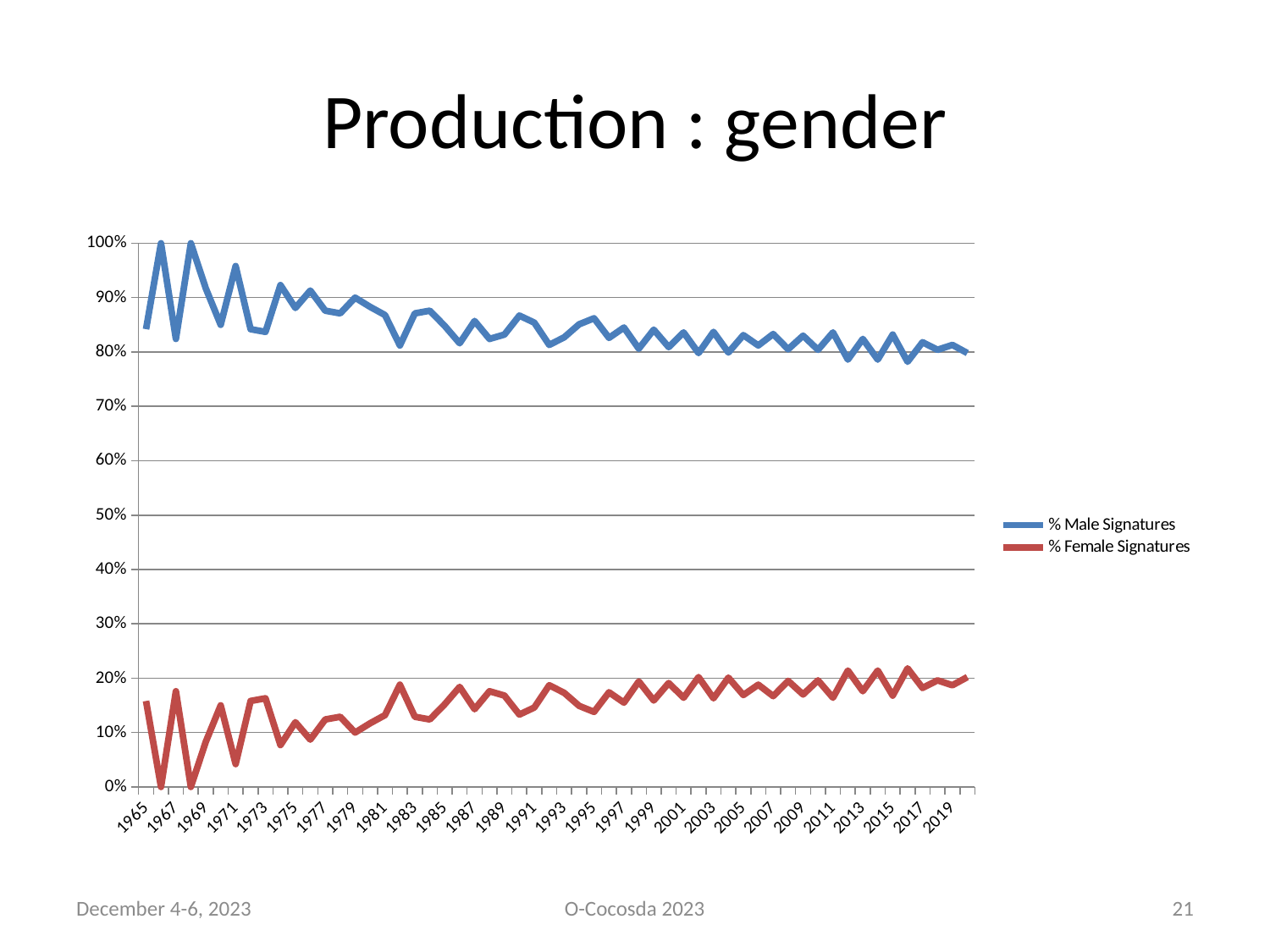
Is the value for % Male Signatures in 1983 greater or less than 90%? less How many series does the legend list? 2 Is the value for % Male Signatures in 2001 greater or less than 70%? greater Does the % Male Signatures line generally rise or fall from 1965 to 2019? fall What is the title of the chart? Production : gender What is the value of % Male Signatures in 1966? 100% What is the value of % Female Signatures in 1966? 0% What kind of chart is shown on the slide? line chart Does the % Female Signatures line generally rise or fall from 1965 to 2019? rise What are the two series named in the legend? % Male Signatures and % Female Signatures Which series has the higher value in 2019, % Male Signatures or % Female Signatures? % Male Signatures